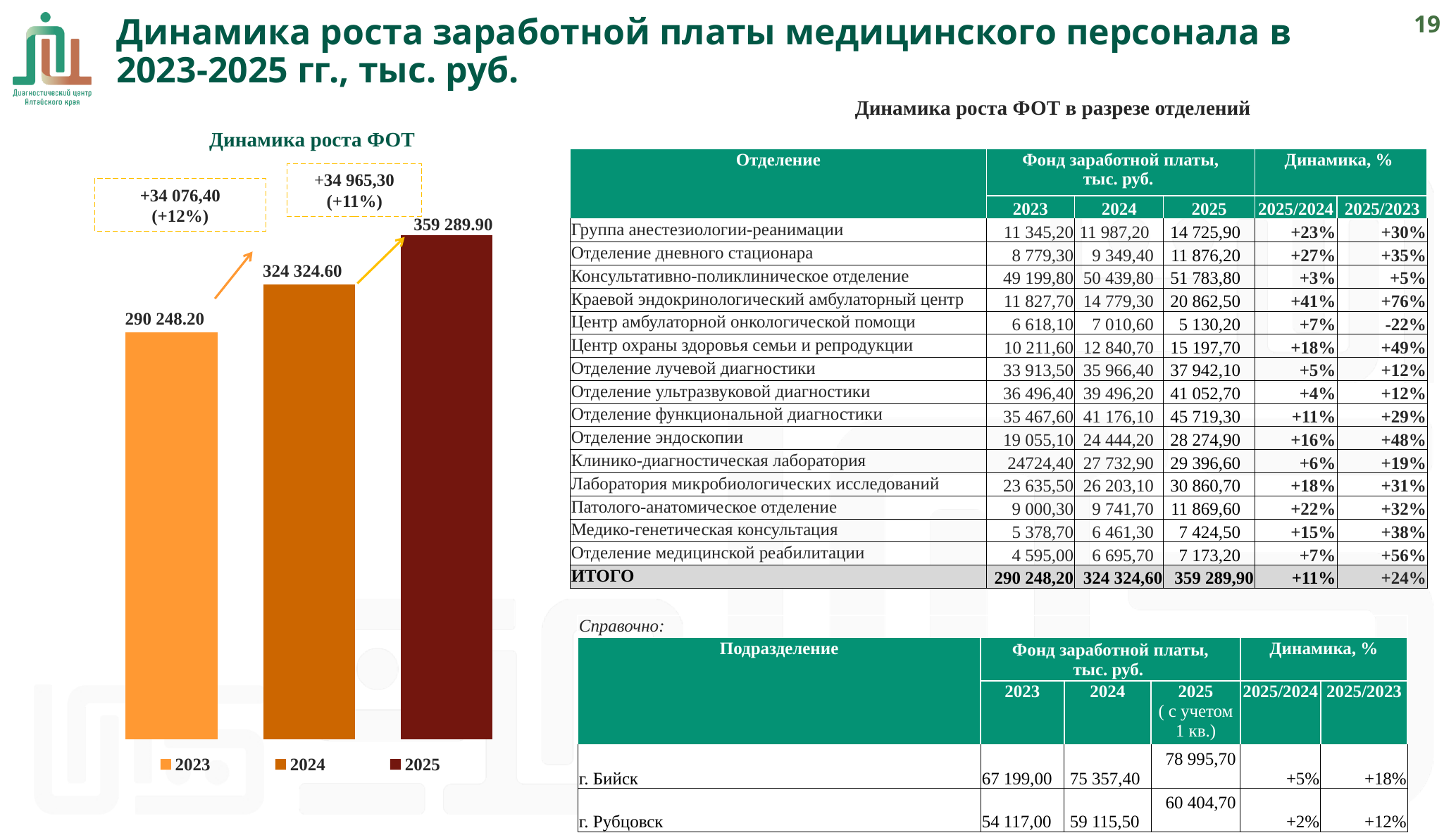
In the chart "Динамика роста ФОТ", which is larger: the value for 2024 or the value for 2025? 2025 Which year has the highest bar in the chart "Динамика роста ФОТ"? 2025 How many bars are plotted in the chart "Динамика роста ФОТ"? 3 Do the values in the chart "Динамика роста ФОТ" rise or fall from 2023 to 2025? Rise In the chart "Динамика роста ФОТ", what is the difference between the 2025 and 2024 values? 34 965.30 What is the value of the 2025 bar in the chart "Динамика роста ФОТ"? 359 289.90 What is the value of the 2023 bar in the chart "Динамика роста ФОТ"? 290 248.20 In the chart "Динамика роста ФОТ", what is the difference between the 2024 and 2023 values? 34 076.40 Which year has the lowest bar in the chart "Динамика роста ФОТ"? 2023 What is the value of the 2024 bar in the chart "Динамика роста ФОТ"? 324 324.60 What type of chart is "Динамика роста ФОТ"? Bar chart In the chart "Динамика роста ФОТ", what is the difference between the 2025 and 2023 values? 69 041.70